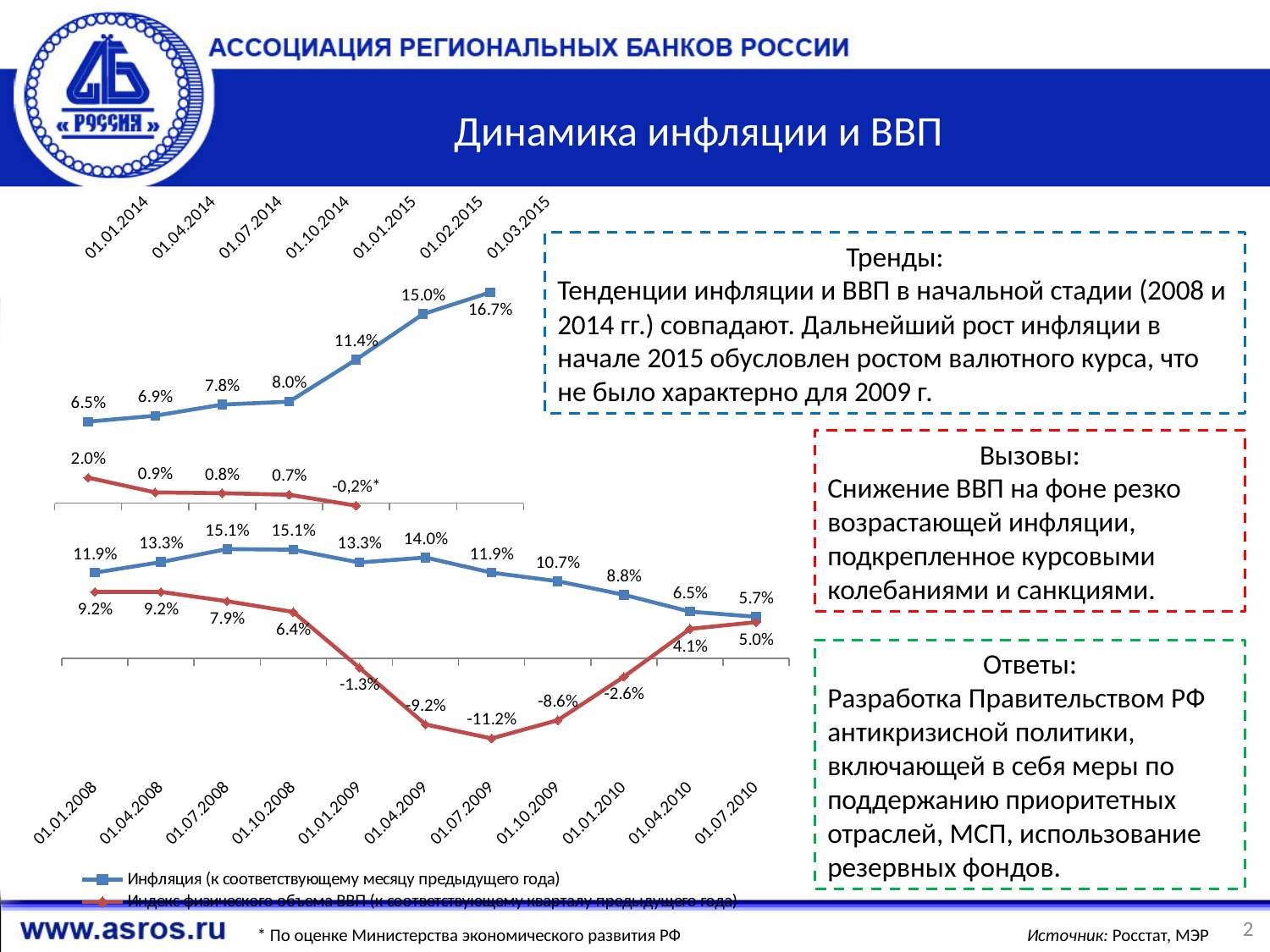
In the bottom chart (2008–2010), what is the GDP index value at 01.07.2009? -11.2% In the top chart (2014–2015), at which date is inflation highest? 01.03.2015 How many series does the legend list? 2 In the top chart (2014–2015), how many data points does the inflation series have? 7 In the top chart (2014–2015), what is the inflation value at 01.03.2015? 16.7% In the top chart (2014–2015), does the GDP index rise or fall from 01.01.2014 to 01.03.2015? Fall In the bottom chart (2008–2010), which is larger at 01.04.2010: inflation or the GDP index? Inflation In the bottom chart (2008–2010), how many dates are shown on the x axis? 11 What type of chart is used on the slide? Line chart In the top chart (2014–2015), what is the GDP index value at 01.01.2014? 2.0% In the bottom chart (2008–2010), at which date is the GDP index lowest? 01.07.2009 In the bottom chart (2008–2010), what is the difference between inflation at 01.07.2008 and at 01.07.2010? 9.4%